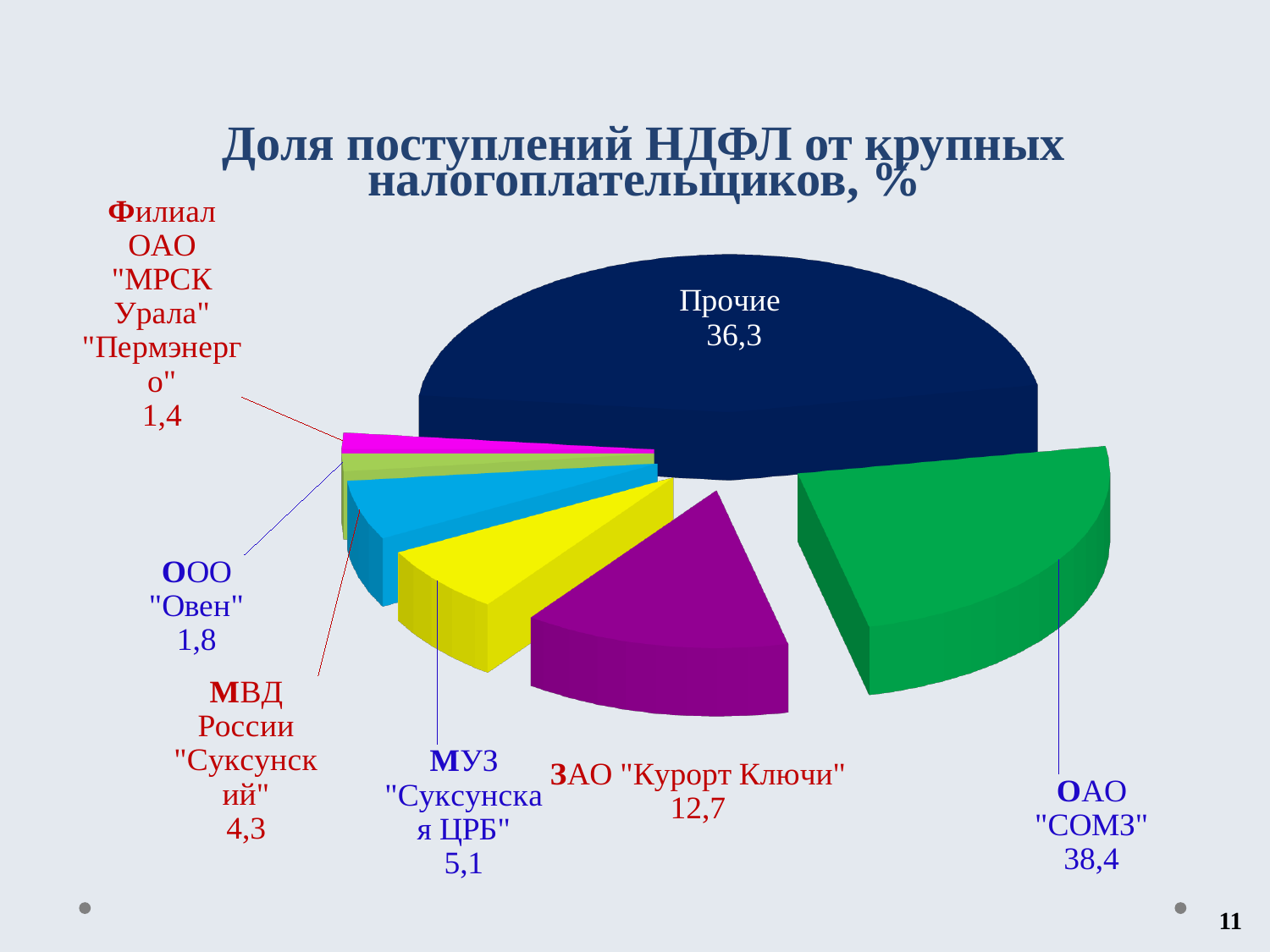
Which is larger: the value for МВД России "Суксунский" or the value for МУЗ "Суксунская ЦРБ"? МУЗ "Суксунская ЦРБ" Which category has the smallest slice? Филиал ОАО "МРСК Урала" "Пермэнерго" How many slices does the pie chart have? 7 What is the value for МУЗ "Суксунская ЦРБ"? 5,1 What is the value for ОАО "СОМЗ"? 38,4 What is the difference between the values for ОАО "СОМЗ" and Прочие? 2,1 What is the value for ООО "Овен"? 1,8 What is the title of the chart? Доля поступлений НДФЛ от крупных налогоплательщиков, % What is the value for ЗАО "Курорт Ключи"? 12,7 What share of the pie does Прочие represent? 36,3% What type of chart is shown on the slide? Pie chart